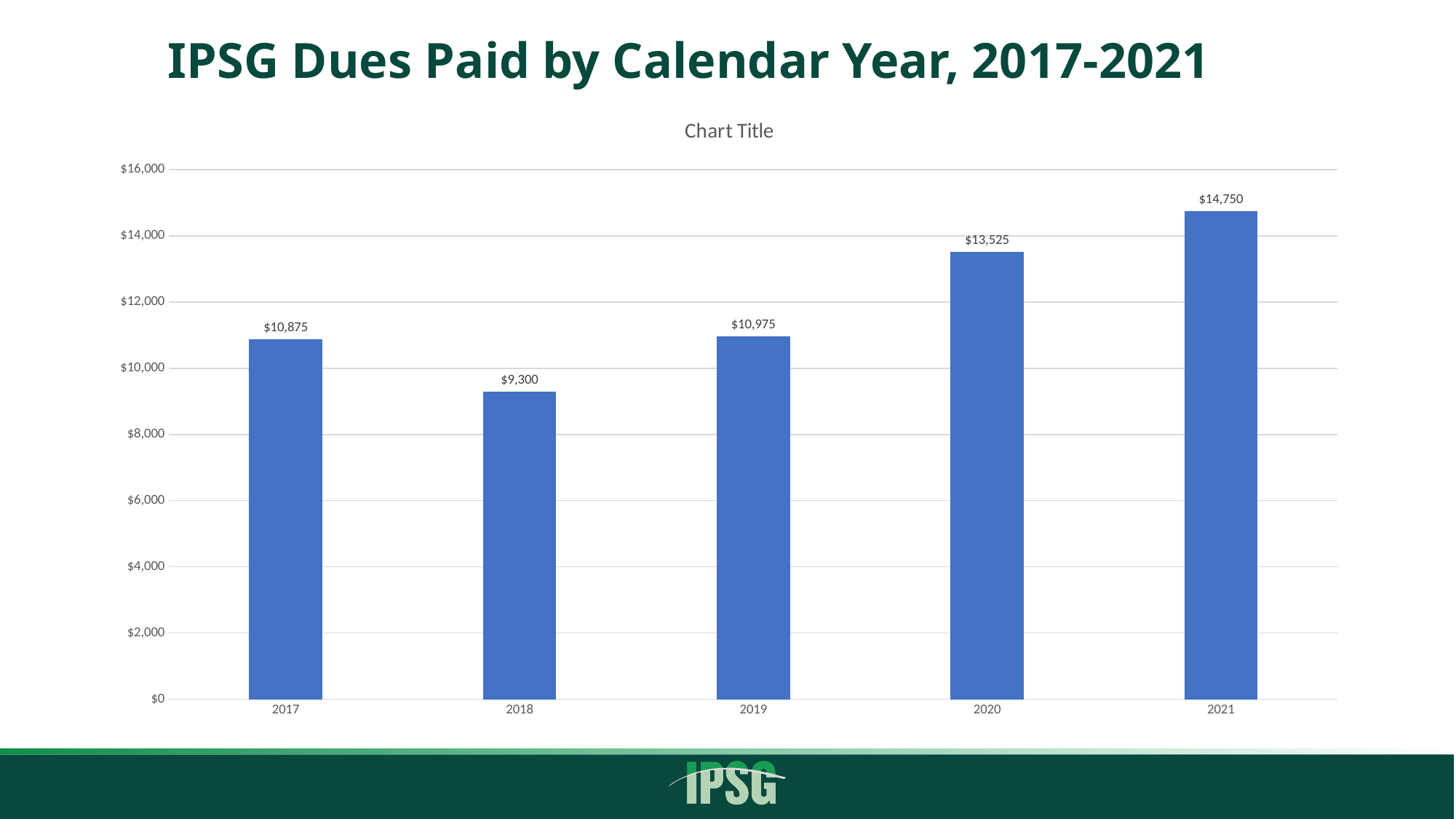
Did dues paid rise or fall from 2018 to 2021? Rise Which year had the lowest dues paid? 2018 What were the IPSG dues paid in 2018? $9,300 What kind of chart is shown on the slide? Bar chart What were the IPSG dues paid in 2017? $10,875 Which year had higher dues paid, 2017 or 2019? 2019 How many years are shown on the chart? 5 What is the difference between dues paid in 2021 and 2020? $1,225 What were the IPSG dues paid in 2020? $13,525 What is the difference between dues paid in 2019 and 2018? $1,675 Which year had the highest dues paid? 2021 Is the value for 2020 greater or less than $12,000? greater